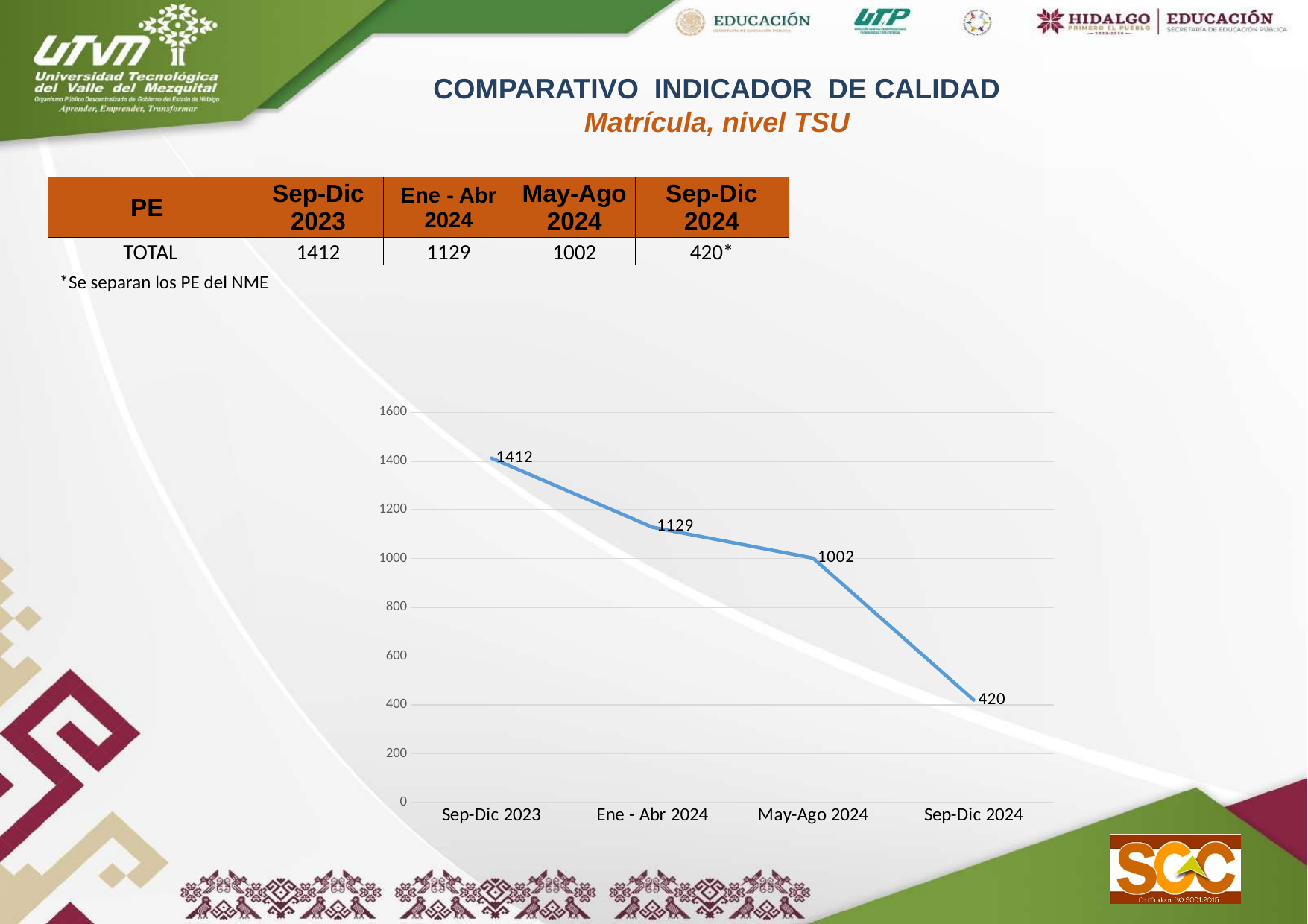
Which period has the lowest value on the chart? Sep-Dic 2024 What is the value plotted for Sep-Dic 2024? 420 Which is larger, the value for Ene - Abr 2024 or the value for May-Ago 2024? Ene - Abr 2024 What is the value plotted for May-Ago 2024? 1002 What is the difference between the values for Ene - Abr 2024 and May-Ago 2024? 127 Which period has the highest value on the chart? Sep-Dic 2023 Do the values rise or fall from Sep-Dic 2023 to Sep-Dic 2024? Fall How many periods are plotted on the x axis of the chart? 4 What is the value plotted for Ene - Abr 2024? 1129 What is the difference between the values for Sep-Dic 2023 and Sep-Dic 2024? 992 What is the value plotted for Sep-Dic 2023? 1412 What kind of chart is shown on the slide? Line chart